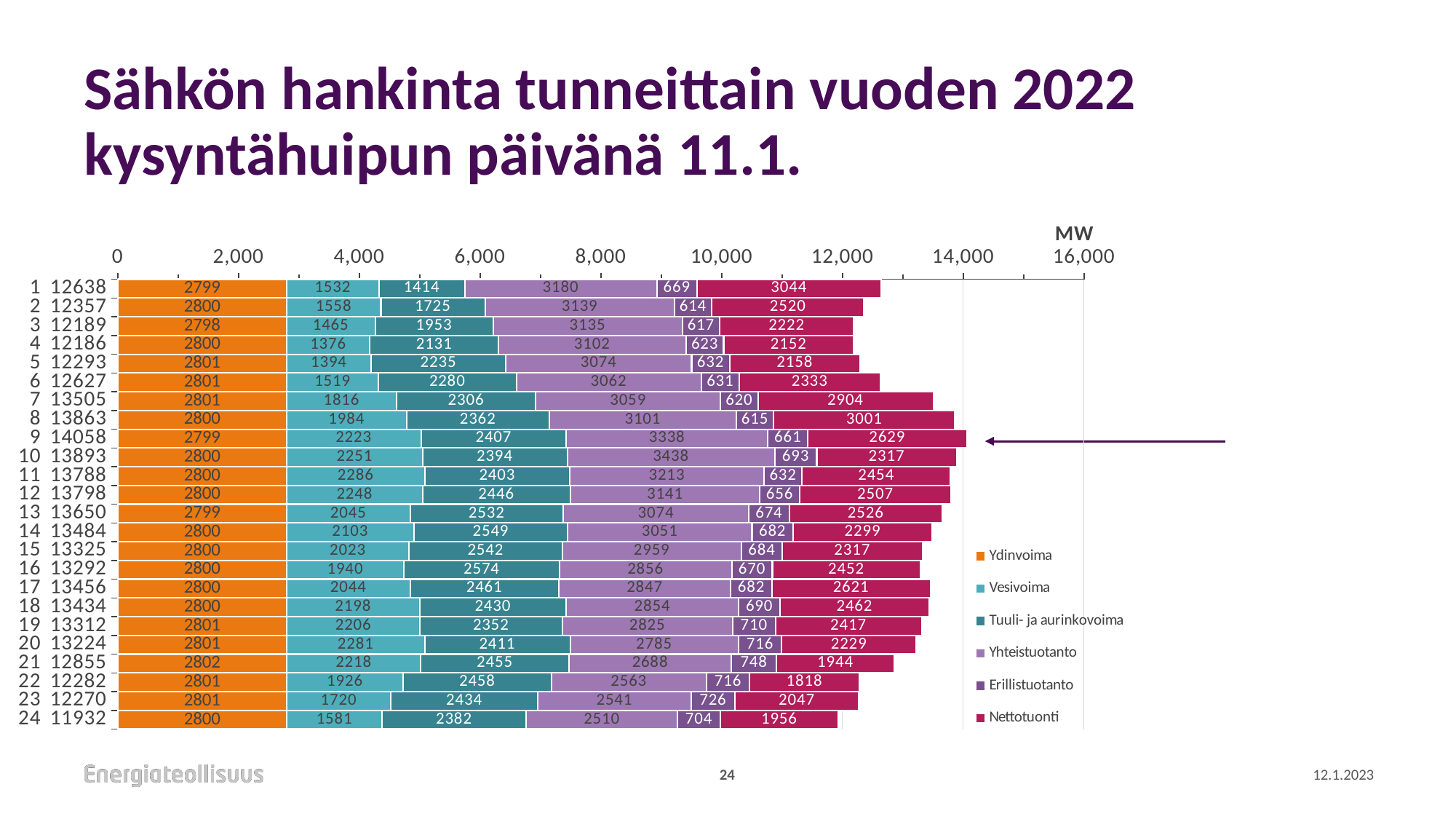
What kind of chart is shown on the slide? bar chart How many series does the legend list? 6 What is the total of the stacked bar for hour 9? 14058 Which hour has the lowest total electricity procurement? 24 What is the Nettotuonti value for hour 1? 3044 What is the Vesivoima value for hour 9? 2223 What is the difference between the Nettotuonti values for hour 1 and hour 2? 524 Is the total for hour 9 greater or less than 14,000? greater What is the Erillistuotanto value for hour 21? 748 How many hours (categories) are plotted on the chart? 24 Which hour has the highest total electricity procurement? 9 Which is larger, the Yhteistuotanto value for hour 9 or for hour 10? hour 10